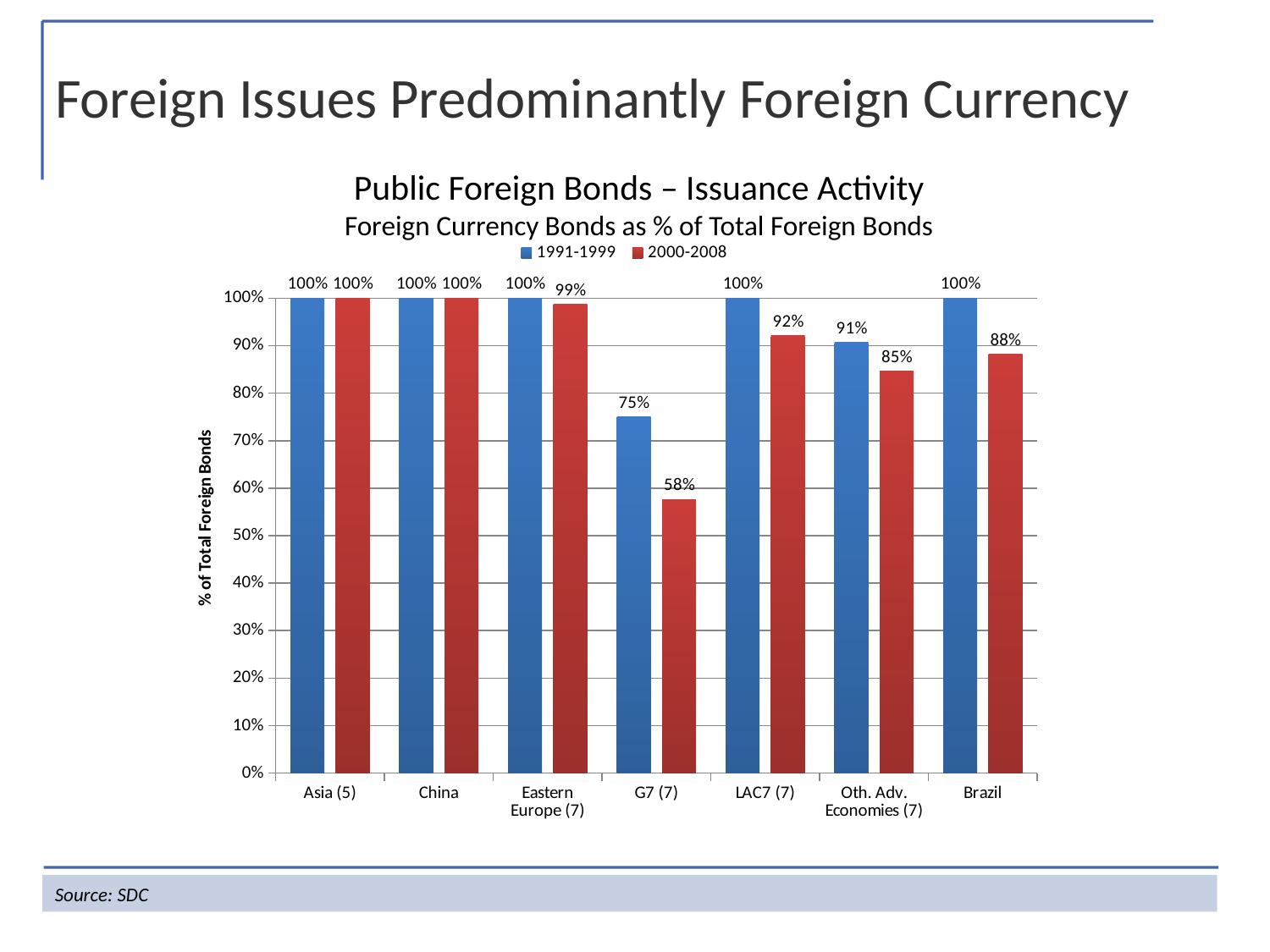
What is the value for LAC7 (7) in the 2000-2008 series? 92% Which is larger for Oth. Adv. Economies (7): the 1991-1999 value or the 2000-2008 value? 1991-1999 How many categories are shown on the x axis? 7 What is the value for Brazil in the 2000-2008 series? 88% Which category has the lowest value in the 1991-1999 series? G7 (7) What is the difference between the 1991-1999 and 2000-2008 values for G7 (7)? 17% How many series does the legend list? 2 What is the value for G7 (7) in the 2000-2008 series? 58% What kind of chart is shown on the slide? Bar chart What is the value for Oth. Adv. Economies (7) in the 1991-1999 series? 91% Which category has the lowest value in the 2000-2008 series? G7 (7) What is the label of the vertical axis? % of Total Foreign Bonds